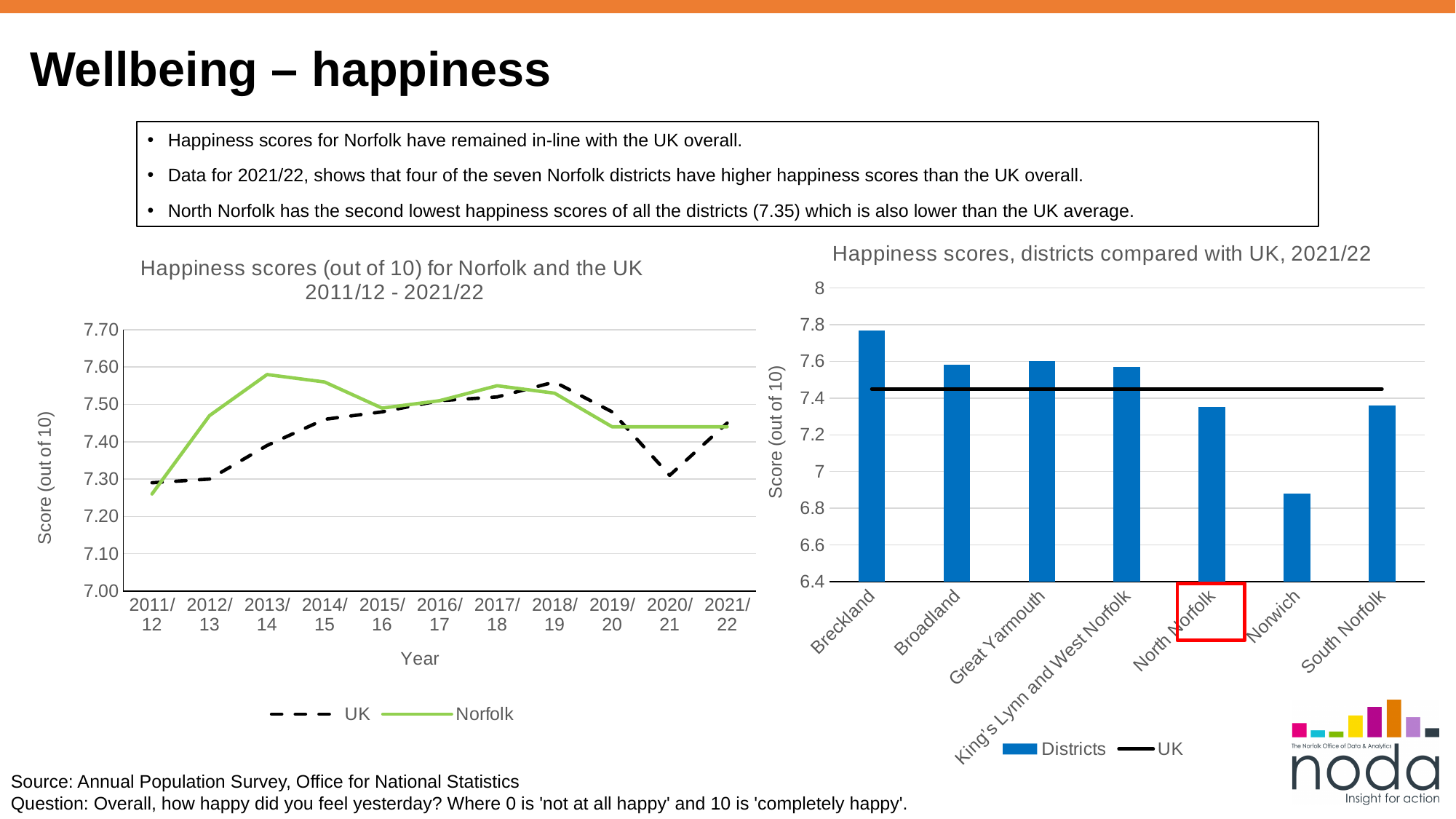
In the left chart, is the UK value for 2020/21 greater or less than 7.40? less In the right chart, is the value for Breckland greater or less than 7.6? greater In the right chart, which has the higher happiness score, Great Yarmouth or North Norfolk? Great Yarmouth What kind of chart is the left chart, 'Happiness scores (out of 10) for Norfolk and the UK 2011/12 - 2021/22'? Line chart In the right chart, how many districts are shown as bars? 7 In the right chart, which district has the lowest happiness score? Norwich In the right chart, which district has the highest happiness score? Breckland In the left chart, how many series does the legend list? 2 In the right chart, what are the two entries listed in the legend? Districts and UK In the right chart, is the value for Norwich greater or less than 7? less In the left chart, does the Norfolk score rise or fall from 2011/12 to 2013/14? Rise What kind of chart is the right chart, 'Happiness scores, districts compared with UK, 2021/22'? Bar chart